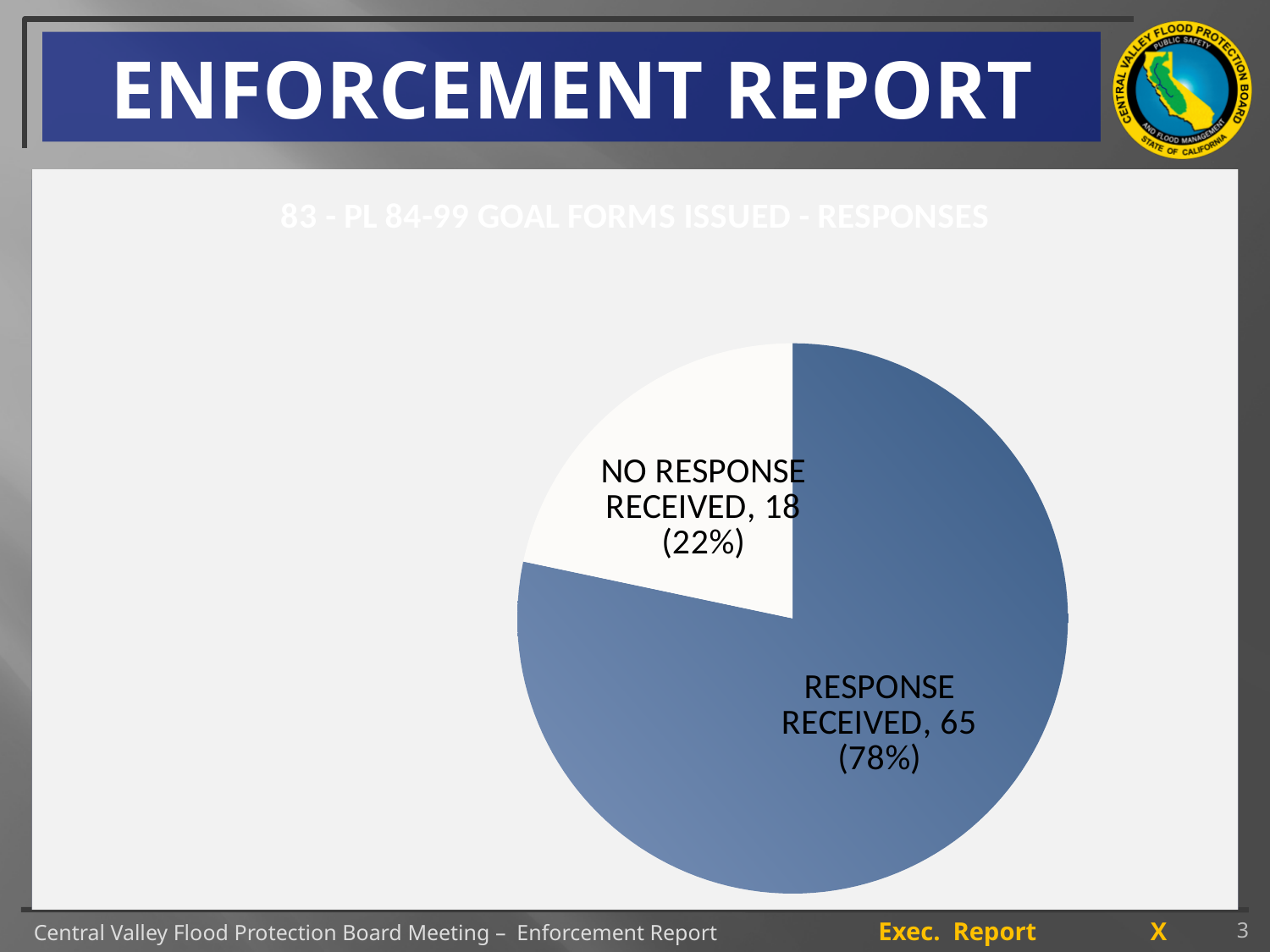
What percentage share of the pie is RESPONSE RECEIVED? 78% What percentage share of the pie is NO RESPONSE RECEIVED? 22% What is the total of the two slices in the pie chart? 83 What is the difference between the RESPONSE RECEIVED and NO RESPONSE RECEIVED values? 47 Which slice is the smallest? NO RESPONSE RECEIVED What kind of chart is shown on the slide? pie chart How many slices does the pie chart have? 2 Which is larger, RESPONSE RECEIVED or NO RESPONSE RECEIVED? RESPONSE RECEIVED What is the value for NO RESPONSE RECEIVED? 18 Which slice is the largest? RESPONSE RECEIVED What is the title of the chart? 83 - PL 84-99 GOAL FORMS ISSUED - RESPONSES What is the value for RESPONSE RECEIVED? 65